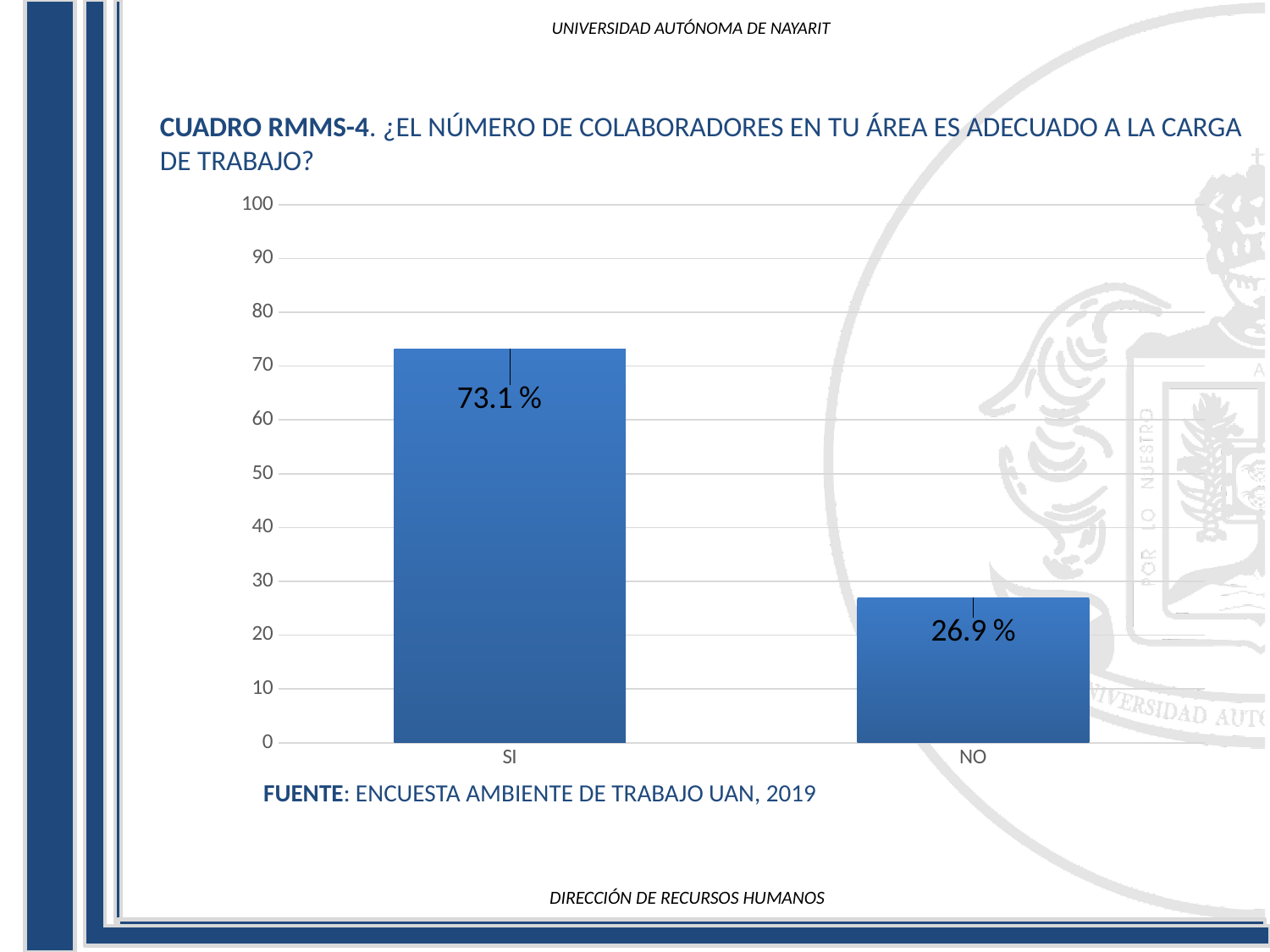
What kind of chart is shown on the slide? bar chart What is the maximum value shown on the y axis? 100 What is the source cited below the chart? ENCUESTA AMBIENTE DE TRABAJO UAN, 2019 What is the value for NO? 26.9 % Which category has the lowest value? NO What is the difference between the values for SI and NO? 46.2 % Is the value for NO greater or less than 30? less Which is larger, the value for SI or the value for NO? SI How many categories are shown on the x axis? 2 What is the value for SI? 73.1 % Is the value for SI greater or less than 70? greater Which category has the highest value? SI